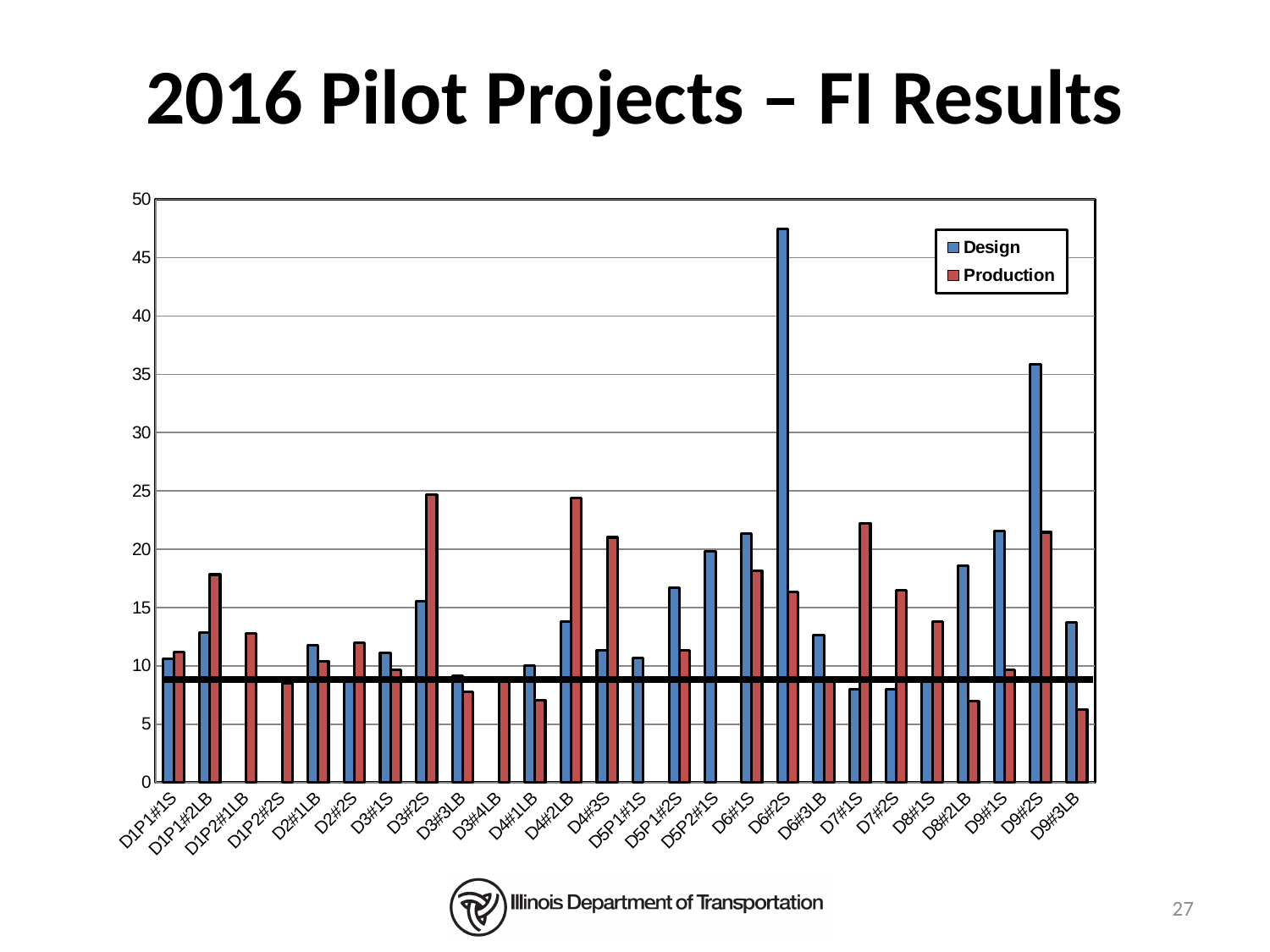
Is the Production value for D9#3LB greater or less than 10? less What kind of chart is shown on the slide? bar chart Is the Design value for D6#2S greater or less than 45? greater Which category has the highest Design value? D6#2S How many project categories are shown on the x axis? 26 How many series does the legend list? 2 What are the two series named in the legend? Design and Production For D3#2S, which is larger, the Design value or the Production value? Production Is the Design value for D9#2S greater or less than 35? greater For D6#2S, which is larger, the Design value or the Production value? Design What is the title of the slide? 2016 Pilot Projects – FI Results